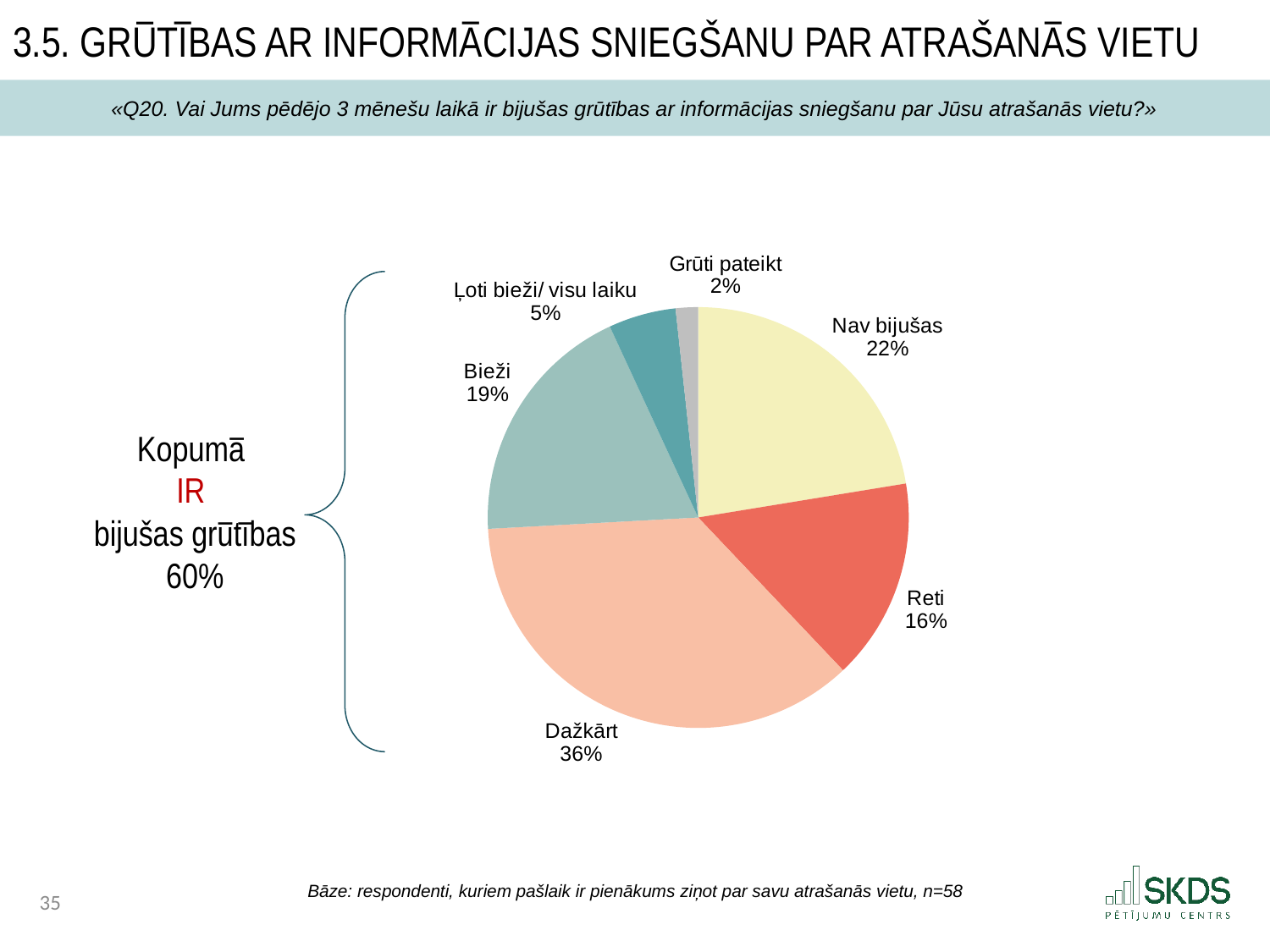
What is the value for "Nav bijušas"? 22% What kind of chart is shown on the slide? pie chart What is the value for "Grūti pateikt"? 2% What is the value for "Ļoti bieži/ visu laiku"? 5% What is the base size (n) stated below the chart? n=58 Which category has the largest slice of the pie? Dažkārt Which category has the smallest slice of the pie? Grūti pateikt What is the combined share of "Reti", "Dažkārt", "Bieži" and "Ļoti bieži/ visu laiku"? 76% How many slices does the pie chart have? 6 What percentage of respondents answered "Dažkārt"? 36% What is the difference between the values for "Bieži" and "Reti"? 3% Which is larger, the value for "Nav bijušas" or the value for "Bieži"? Nav bijušas